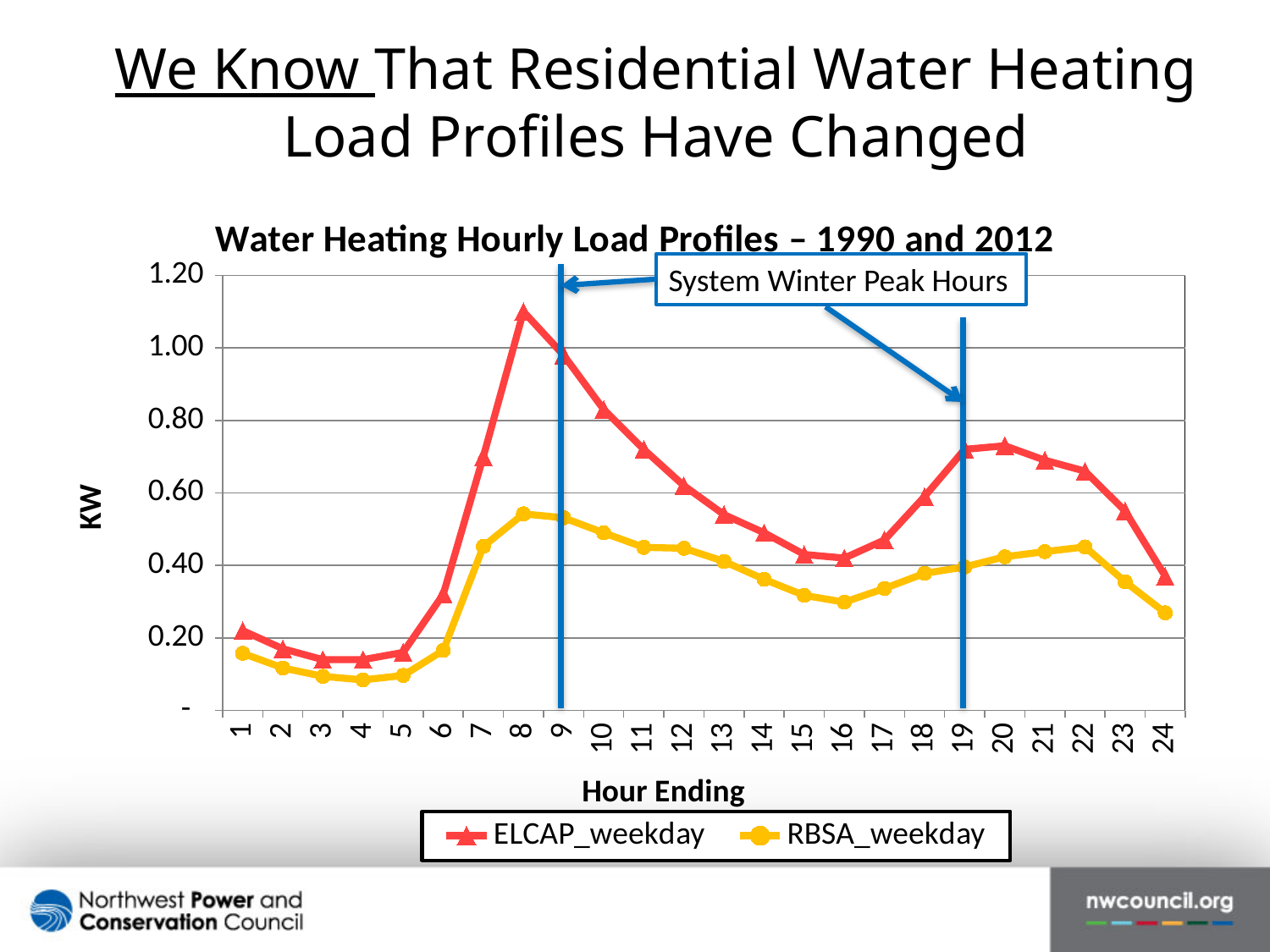
Is the ELCAP_weekday value at hour ending 20 greater or less than 0.80? less What kind of chart is shown on the slide? Line chart Is the RBSA_weekday value at hour ending 16 greater or less than 0.40? less What label is given to the y axis of the chart? KW At which hour ending does the ELCAP_weekday series reach its highest value? 8 How many series does the legend list? 2 Does the ELCAP_weekday series rise or fall from hour ending 8 to hour ending 16? Fall What is the title of the chart? Water Heating Hourly Load Profiles – 1990 and 2012 Is the ELCAP_weekday value at hour ending 8 greater or less than 1.00? greater Which series has the larger value at hour ending 8, ELCAP_weekday or RBSA_weekday? ELCAP_weekday How many hours are plotted along the x axis? 24 At which hour ending does the RBSA_weekday series reach its highest value? 8